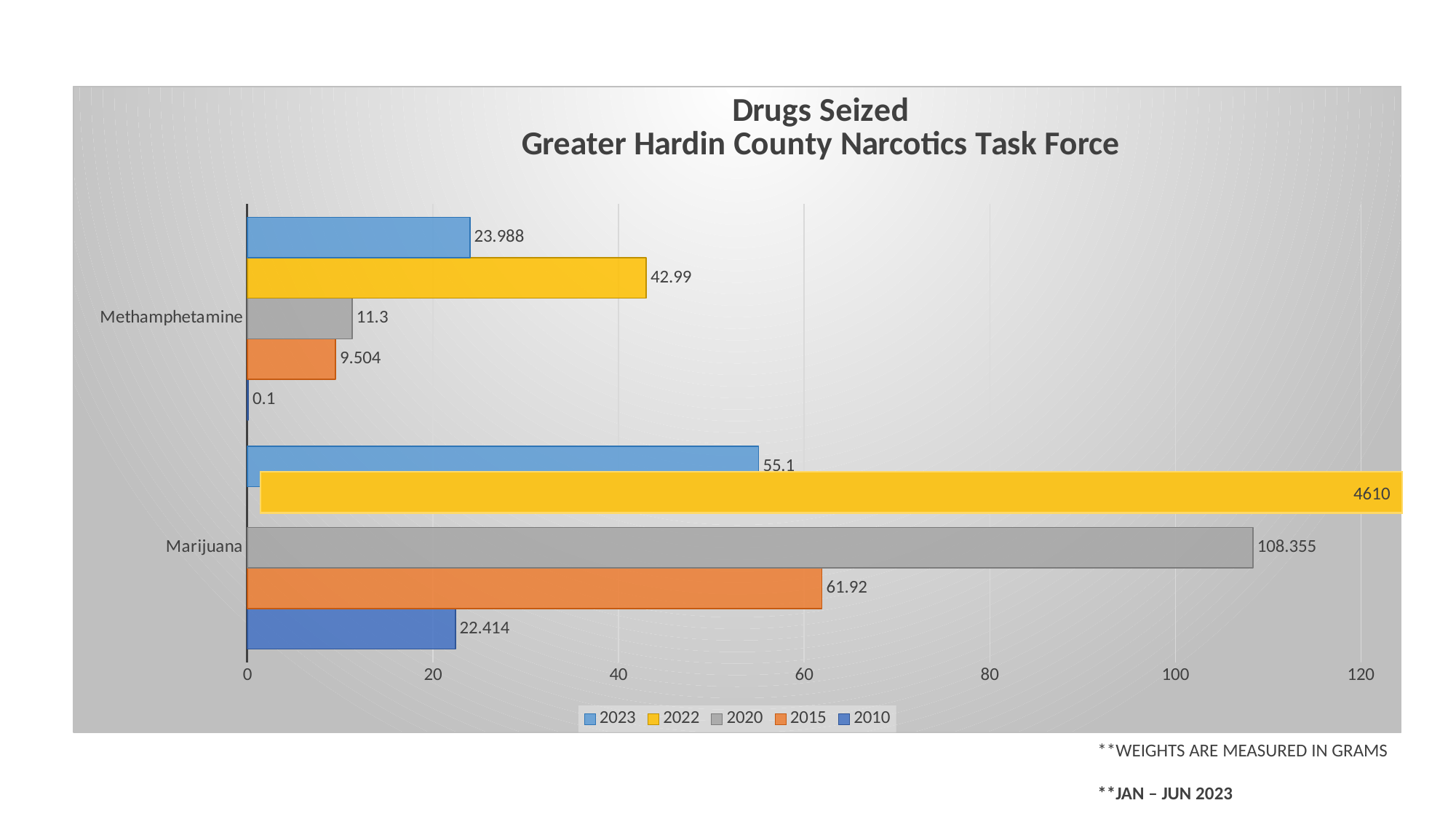
Which year has the lowest value for Methamphetamine? 2010 What is the value for Methamphetamine in 2010? 0.1 Which is larger: the Methamphetamine value for 2023 or for 2020? 2023 How many series does the legend list? 5 What is the difference between the Marijuana values for 2015 and 2010? 39.506 What is the value for Marijuana in 2020? 108.355 What is the title of the chart? Drugs Seized Greater Hardin County Narcotics Task Force What type of chart is shown on the slide? bar chart Which year has the highest value for Marijuana? 2022 What is the value for Methamphetamine in 2022? 42.99 What is the value for Marijuana in 2023? 55.1 How many drug categories are shown on the chart? 2